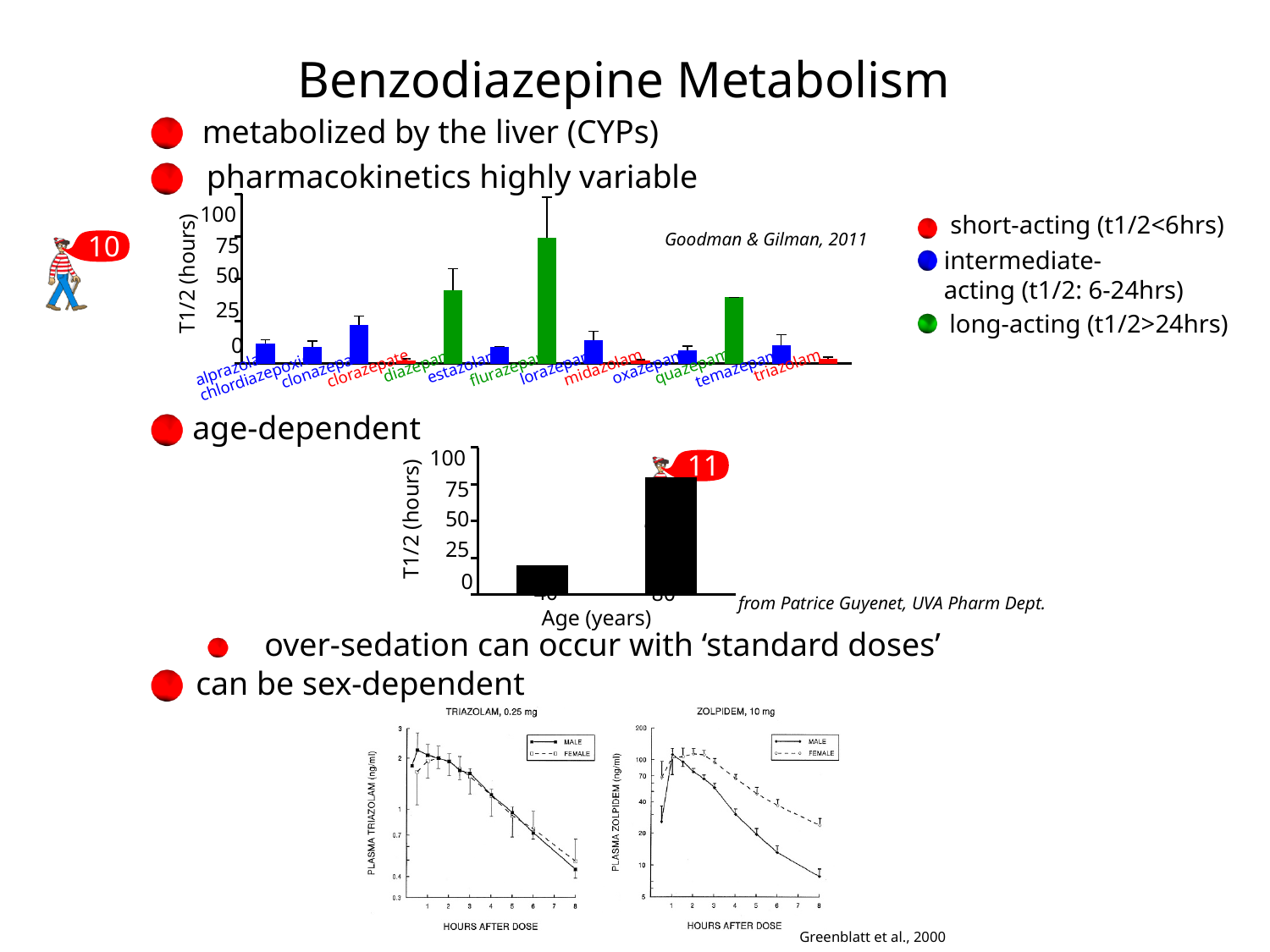
In the ZOLPIDEM, 10 mg chart at the bottom of the slide, which series has the higher plasma concentration at 8 hours after dose? FEMALE In the top T1/2 (hours) bar chart, which drug has the highest half-life? flurazepam In the age-dependent T1/2 chart in the middle of the slide, is the value for the right-hand (older age) bar greater or less than 75? greater In the age-dependent T1/2 chart in the middle of the slide, how many bars are plotted? 2 How many series does the legend list in the ZOLPIDEM, 10 mg chart at the bottom of the slide? 2 How many drugs are plotted in the top T1/2 (hours) bar chart? 13 In the top T1/2 (hours) bar chart, is the value for flurazepam greater or less than 50? greater In the top T1/2 (hours) bar chart, is the value for clorazepate greater or less than 25? less In the top T1/2 (hours) bar chart, which has the larger half-life, diazepam or alprazolam? diazepam What kind of chart is the top chart showing T1/2 (hours) for the benzodiazepines? bar chart What is the y-axis label of the top bar chart? T1/2 (hours)